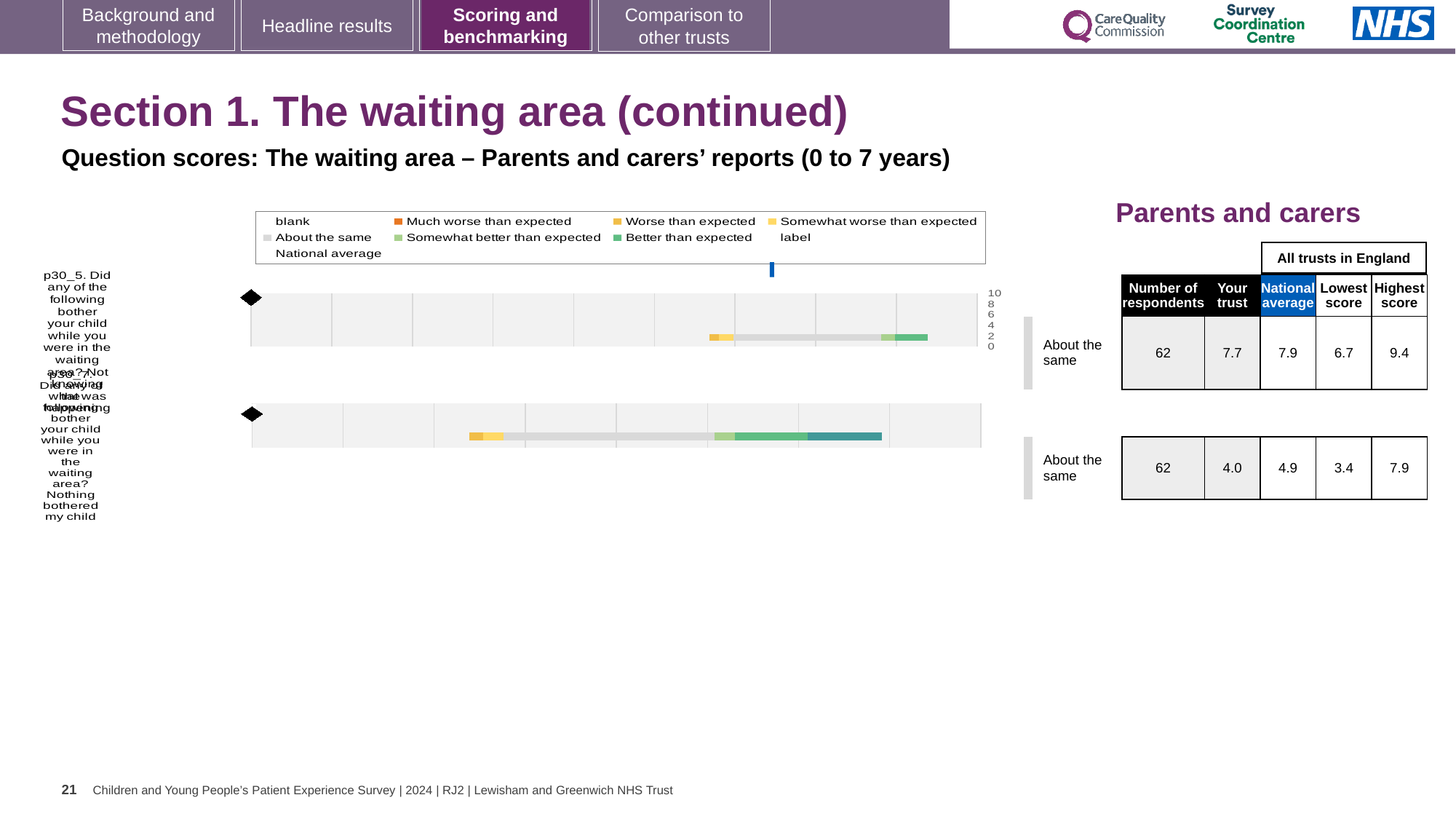
How many respondents answered question p30_5 (Not knowing what was happening)? 62 What benchmark category is the trust placed in for question p30_5 (Not knowing what was happening)? About the same What is the national average score for question p30_5 (Not knowing what was happening)? 7.9 How many survey questions are plotted as bars in the chart? 2 What kind of chart is used to show the question scores for the waiting area? bar chart Which is larger for question p30_7 (Nothing bothered my child): the trust's score or the national average? National average What is the difference between the national average and the trust's score for question p30_5 (Not knowing what was happening)? 0.2 What is the 'Your trust' score for question p30_5 (Did any of the following bother your child while you were in the waiting area? Not knowing what was happening)? 7.7 Which respondent group does the chart heading above the table refer to? Parents and carers What is the difference between the highest and lowest scores across all trusts for question p30_7 (Nothing bothered my child)? 4.5 What is the 'Your trust' score for question p30_7 (Nothing bothered my child)? 4.0 What is the highest score among all trusts in England for question p30_7 (Nothing bothered my child)? 7.9